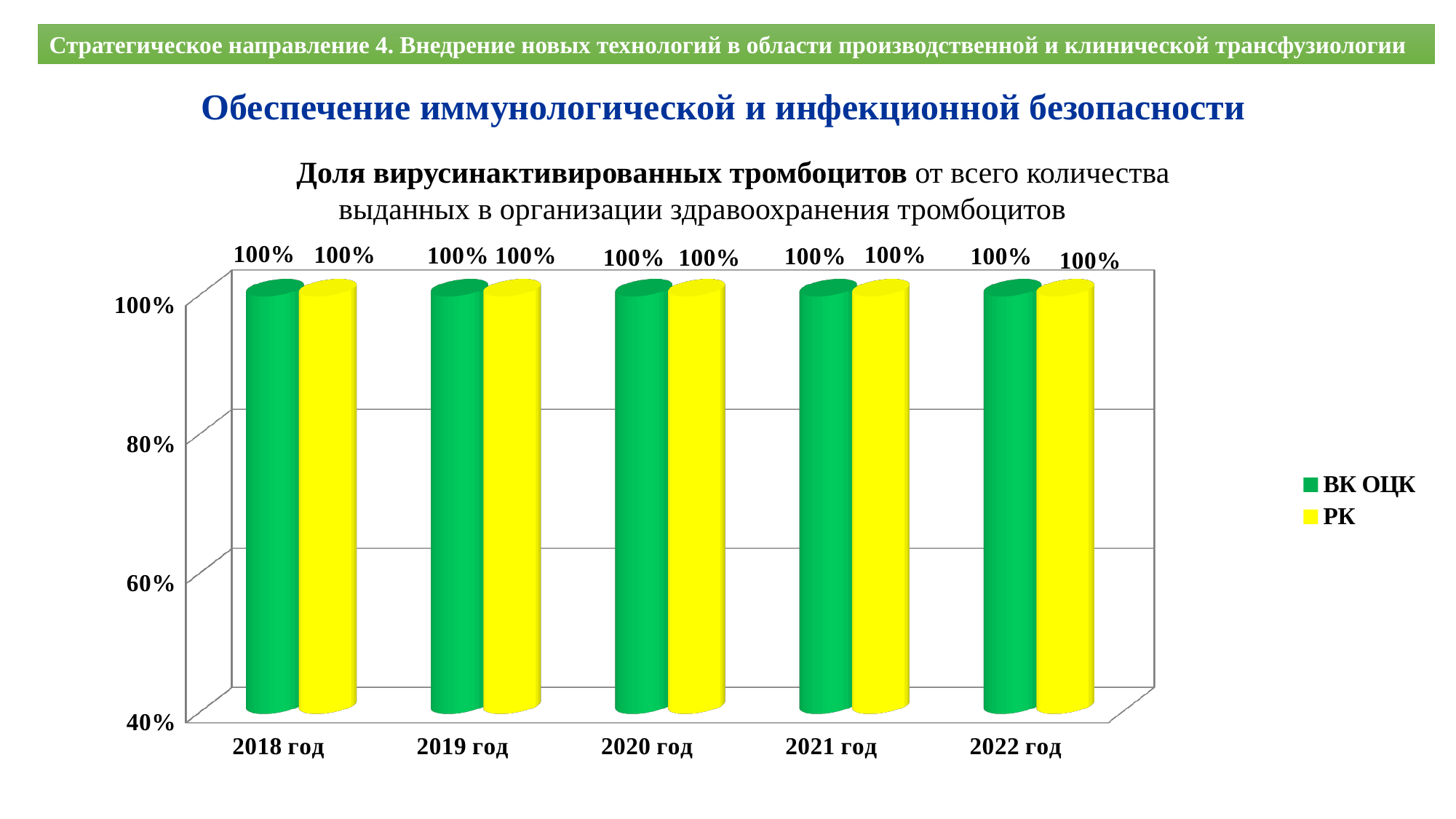
What kind of chart is shown on the slide? bar chart Which series is shown in yellow in the legend? РК Do the values for ВК ОЦК rise, fall or stay the same from 2018 год to 2022 год? stay the same What is the lowest value shown on the vertical axis? 40% What is the value for ВК ОЦК in 2020 год? 100% What is the value for ВК ОЦК in 2018 год? 100% How many years are shown on the x axis? 5 How many series does the legend list? 2 Is the value for ВК ОЦК in 2022 год greater or less than 80%? greater What is the value for РК in 2022 год? 100% What is the value for РК in 2019 год? 100% What is the difference between the ВК ОЦК and РК values in 2021 год? 0%